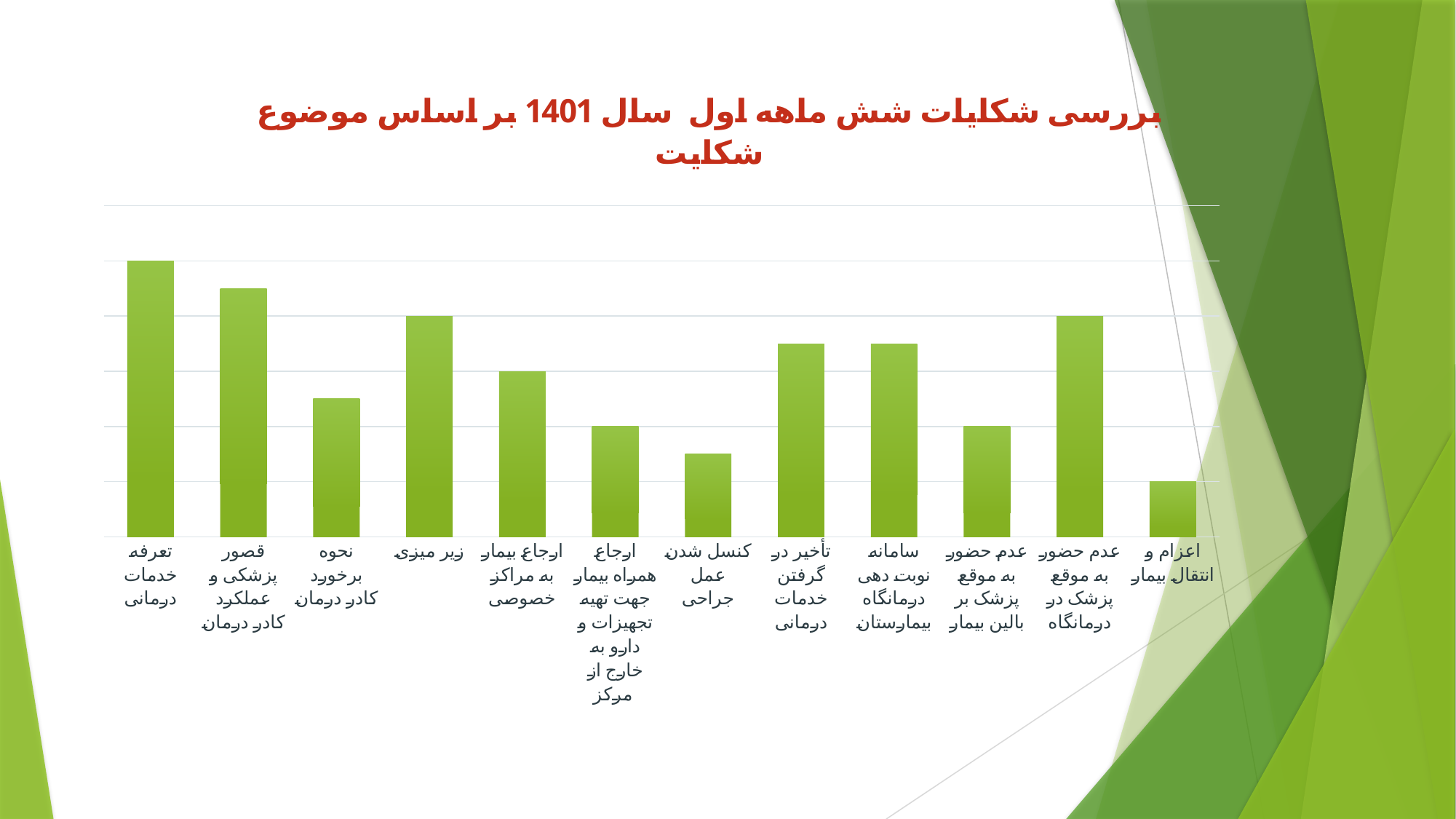
Which is larger, the value for کنسل شدن عمل جراحی or the value for ارجاع همراه بیمار جهت تهیه تجهیزات و دارو به خارج از مرکز? ارجاع همراه بیمار جهت تهیه تجهیزات و دارو به خارج از مرکز What is the title of the chart? بررسی شکایات شش ماهه اول سال 1401 بر اساس موضوع شکایت What kind of chart is shown on the slide? bar chart Which is larger, the value for تعرفه خدمات درمانی or the value for قصور پزشکی و عملکرد کادر درمان? تعرفه خدمات درمانی Which is larger, the value for نحوه برخورد کادر درمان or the value for ارجاع بیمار به مراکز خصوصی? ارجاع بیمار به مراکز خصوصی Which category has the highest bar? تعرفه خدمات درمانی How many categories (bars) does the chart show? 12 What colour are the bars in the chart? green Which category has the lowest bar? اعزام و انتقال بیمار